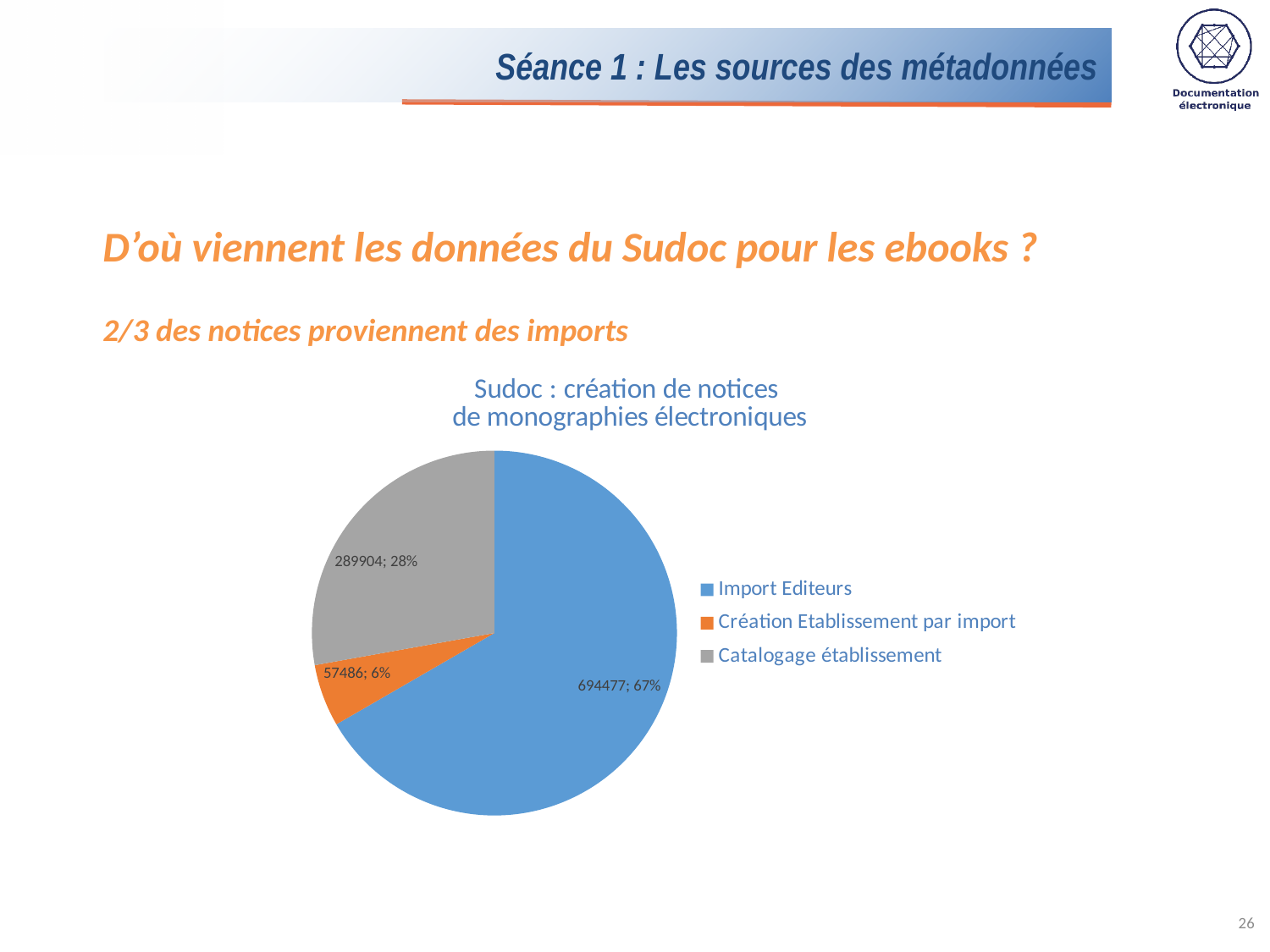
What share of the pie does Import Editeurs represent? 67% Which category has the largest slice? Import Editeurs Which category has the smallest slice? Création Etablissement par import How many entries does the legend list? 3 How many slices does the pie chart have? 3 What kind of chart is shown on the slide? pie chart What is the title of the chart? Sudoc : création de notices de monographies électroniques What is the value for Catalogage établissement? 289904 What is the value for Création Etablissement par import? 57486 What is the difference between the values for Import Editeurs and Catalogage établissement? 404573 What share of the pie does Catalogage établissement represent? 28% What is the value for Import Editeurs? 694477